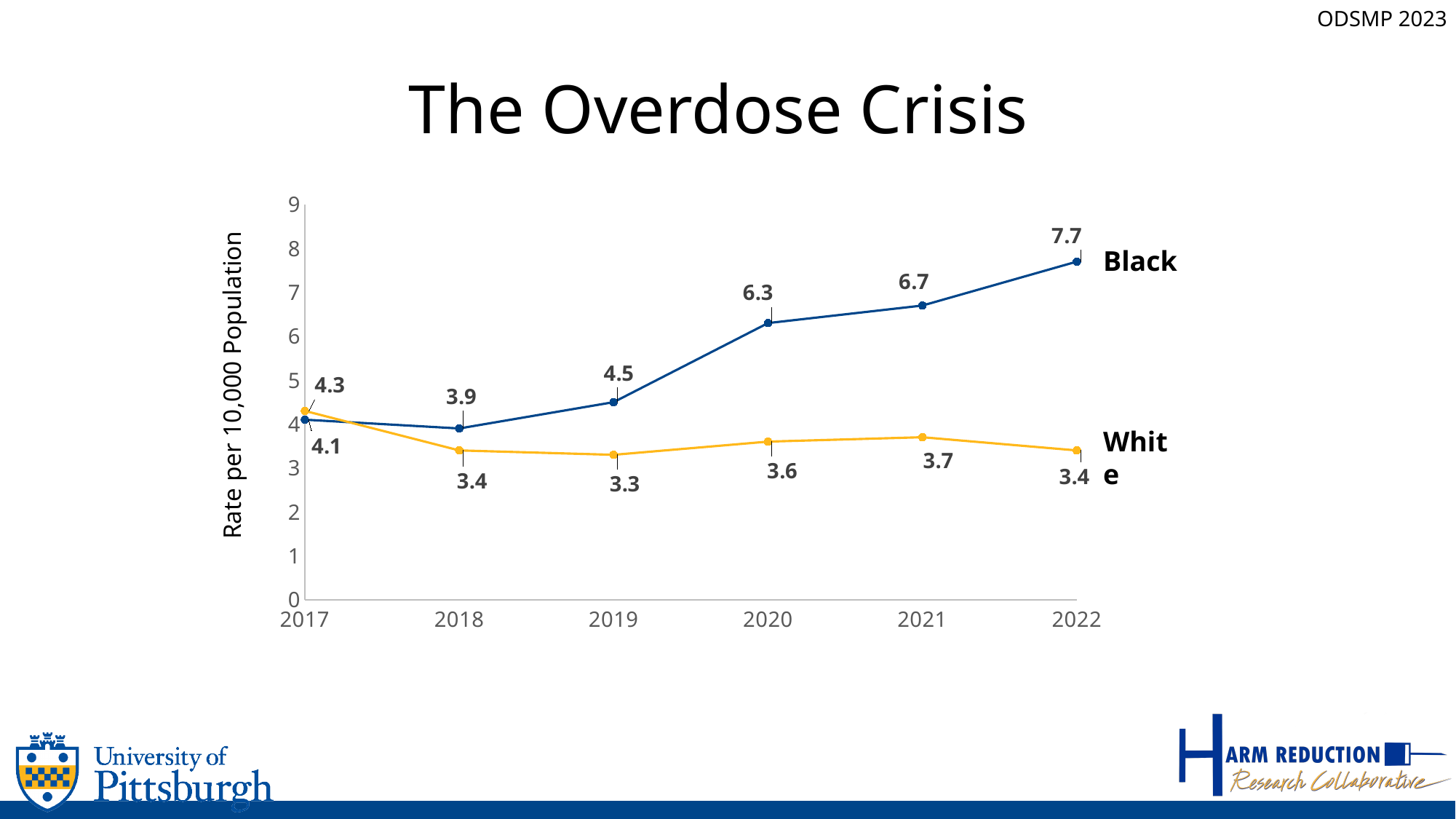
What is the rate for the Black series in 2022? 7.7 Which series has the higher rate in 2017, Black or White? White What is the difference between the Black and White rates in 2022? 4.3 What is the label of the y axis? Rate per 10,000 Population What is the rate for the Black series in 2020? 6.3 How many years are plotted on the x axis? 6 In which year is the White series at its lowest? 2019 In which year is the Black series at its highest? 2022 What kind of chart is shown on the slide? line chart How many series are plotted on the chart? 2 What is the rate for the White series in 2017? 4.3 What is the rate for the White series in 2019? 3.3